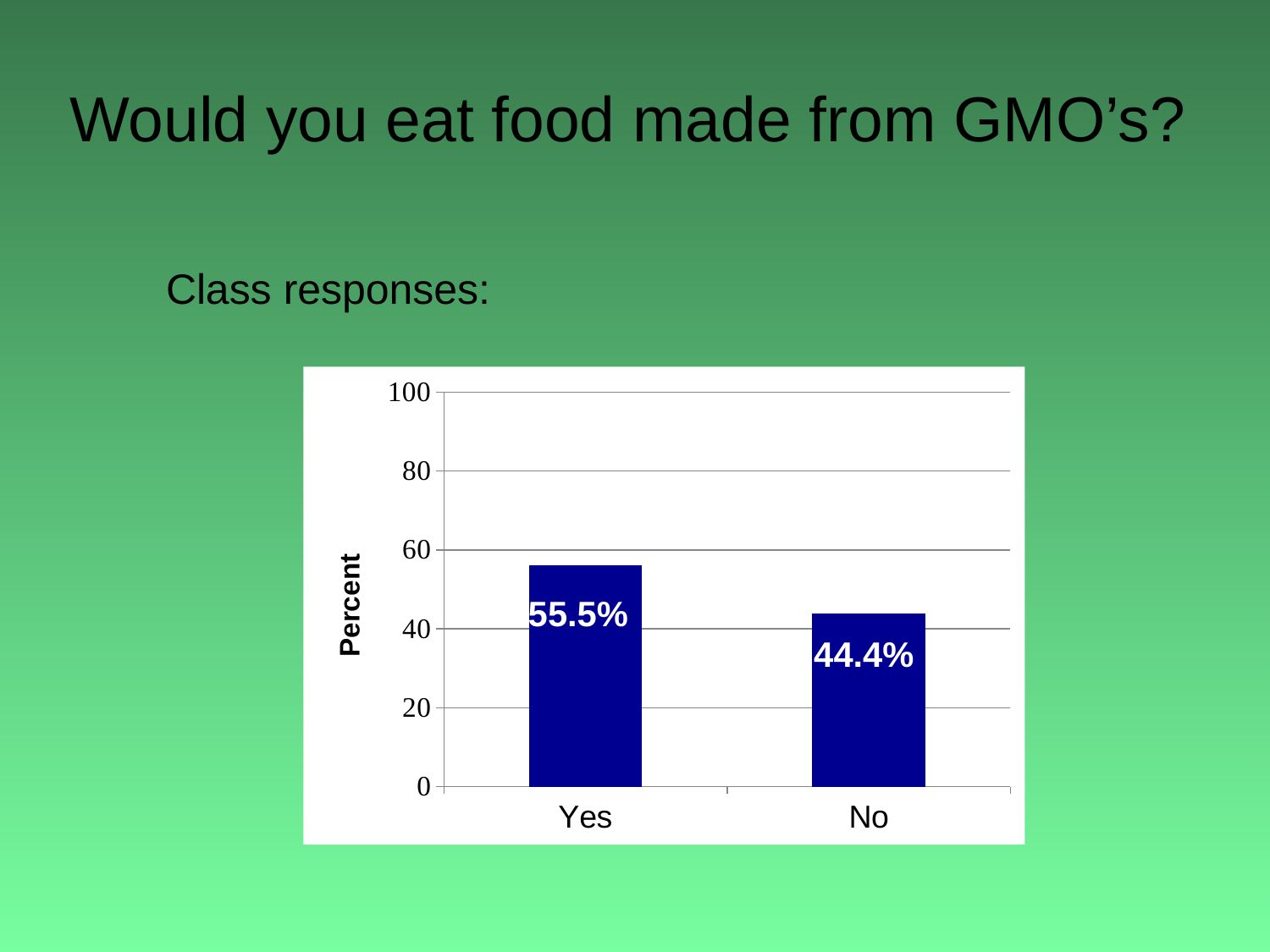
Which response has the lower percentage? No What is the maximum value shown on the vertical axis? 100 What percentage of the class answered Yes? 55.5% What kind of chart is shown on the slide? bar chart How many response categories are shown on the chart? 2 Is the value for No greater or less than 40? greater Which response has the higher percentage, Yes or No? Yes What percentage of the class answered No? 44.4% Is the value for Yes greater or less than 60? less What is the label on the vertical axis of the chart? Percent What is the difference in percentage points between the Yes and No responses? 11.1